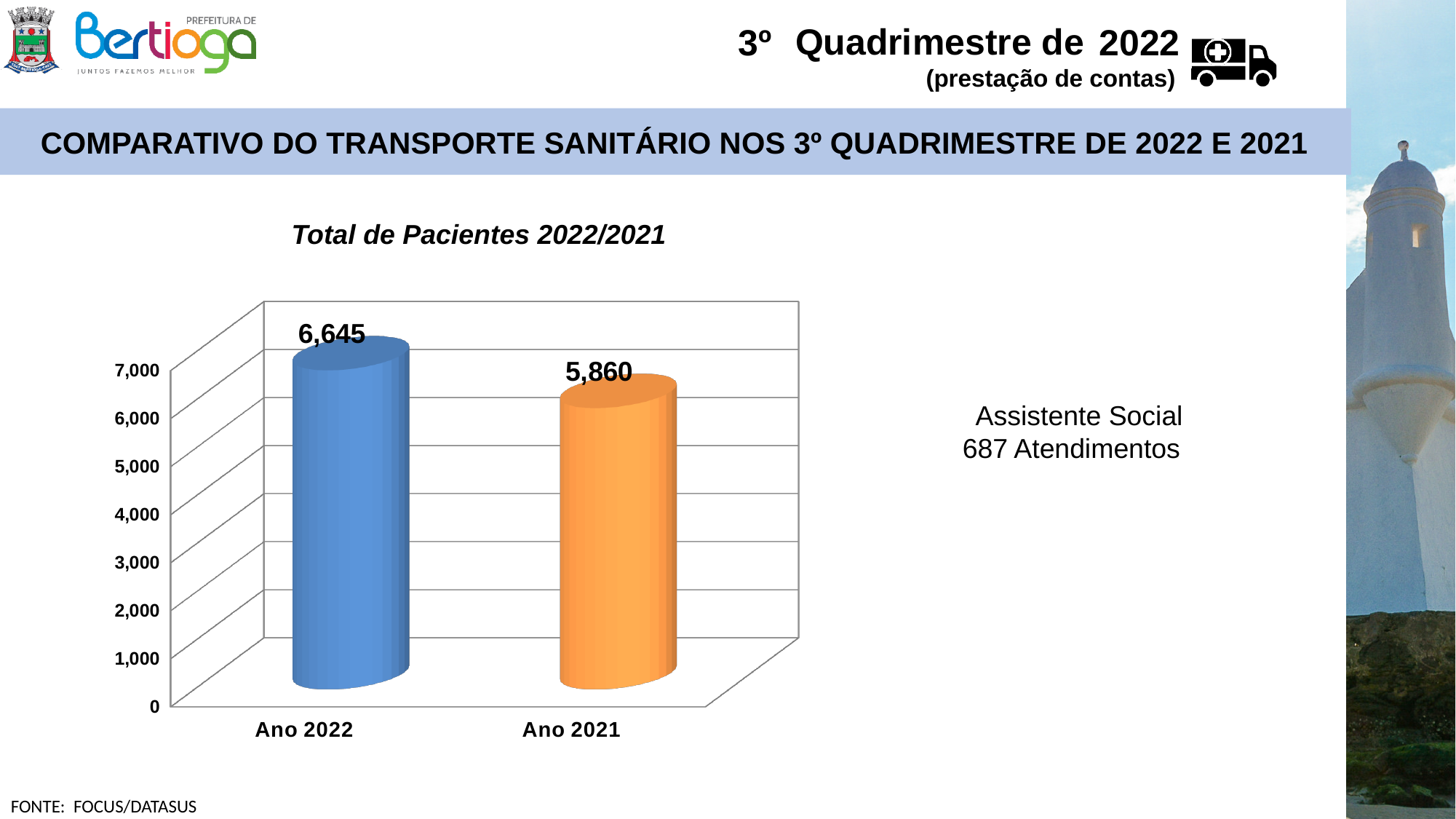
Is the value for Ano 2021 greater or less than 6,000? less What is the value for Ano 2022? 6,645 What is the title of the chart? Total de Pacientes 2022/2021 What is the difference between the values for Ano 2022 and Ano 2021? 785 How many categories are shown on the x axis? 2 Which is larger, the value for Ano 2022 or the value for Ano 2021? Ano 2022 Which category has the highest value? Ano 2022 Is the value for Ano 2022 greater or less than 6,000? greater What kind of chart is shown on the slide? bar chart Which category has the lowest value? Ano 2021 What colour is the bar for Ano 2021? orange What is the value for Ano 2021? 5,860